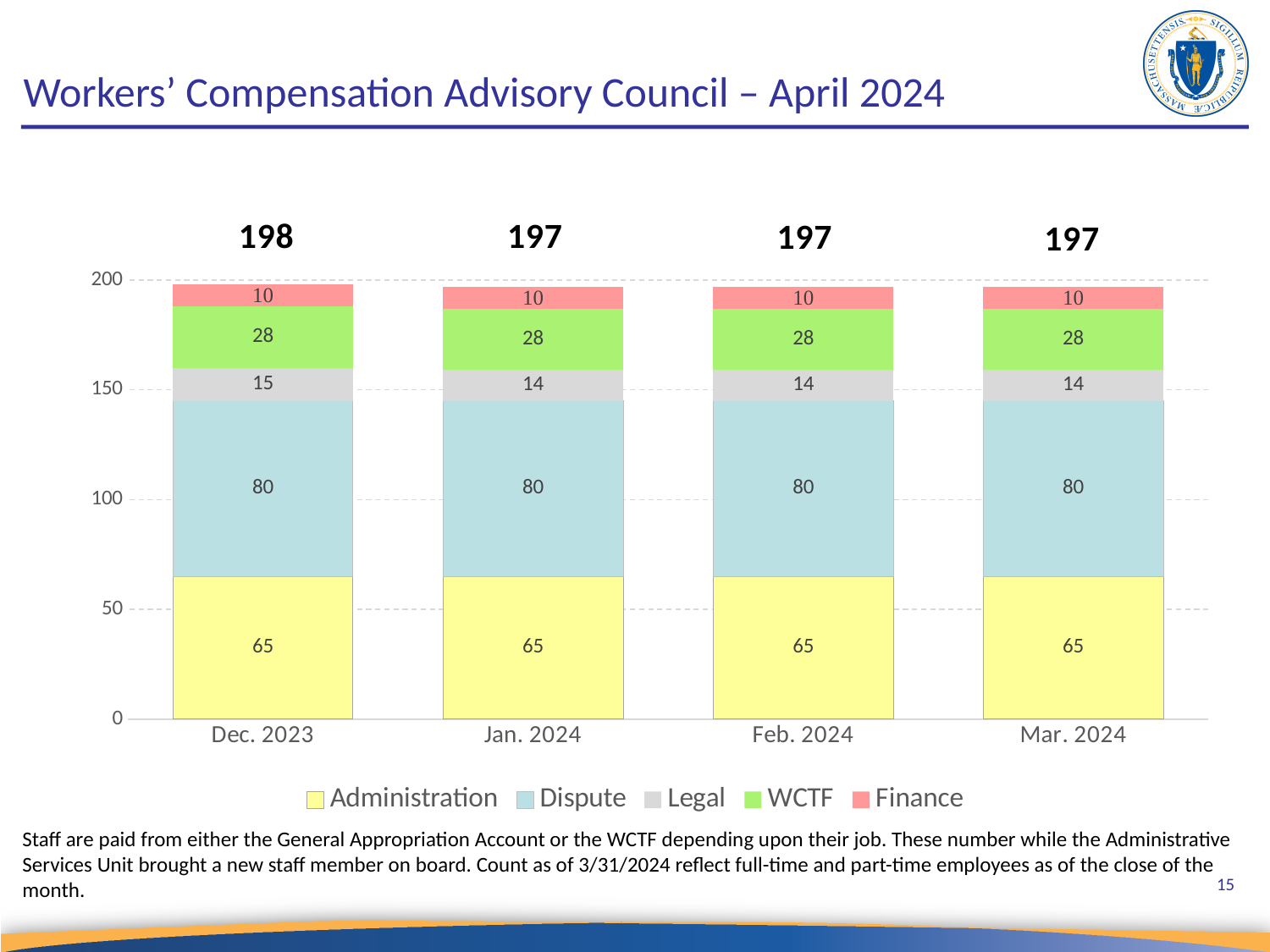
How many series does the legend list? 5 What is the Legal value for Dec. 2023? 15 How many months are shown on the x axis? 4 What is the Legal value for Mar. 2024? 14 What is the WCTF value for Feb. 2024? 28 What is the total of the stacked bar for Dec. 2023? 198 Which is larger for Feb. 2024, the WCTF value or the Legal value? WCTF What is the total of the stacked bar for Mar. 2024? 197 What is the Administration value for Dec. 2023? 65 Which month has the highest total? Dec. 2023 What is the Finance value for Jan. 2024? 10 What is the difference between the Dispute and Administration values for Jan. 2024? 15